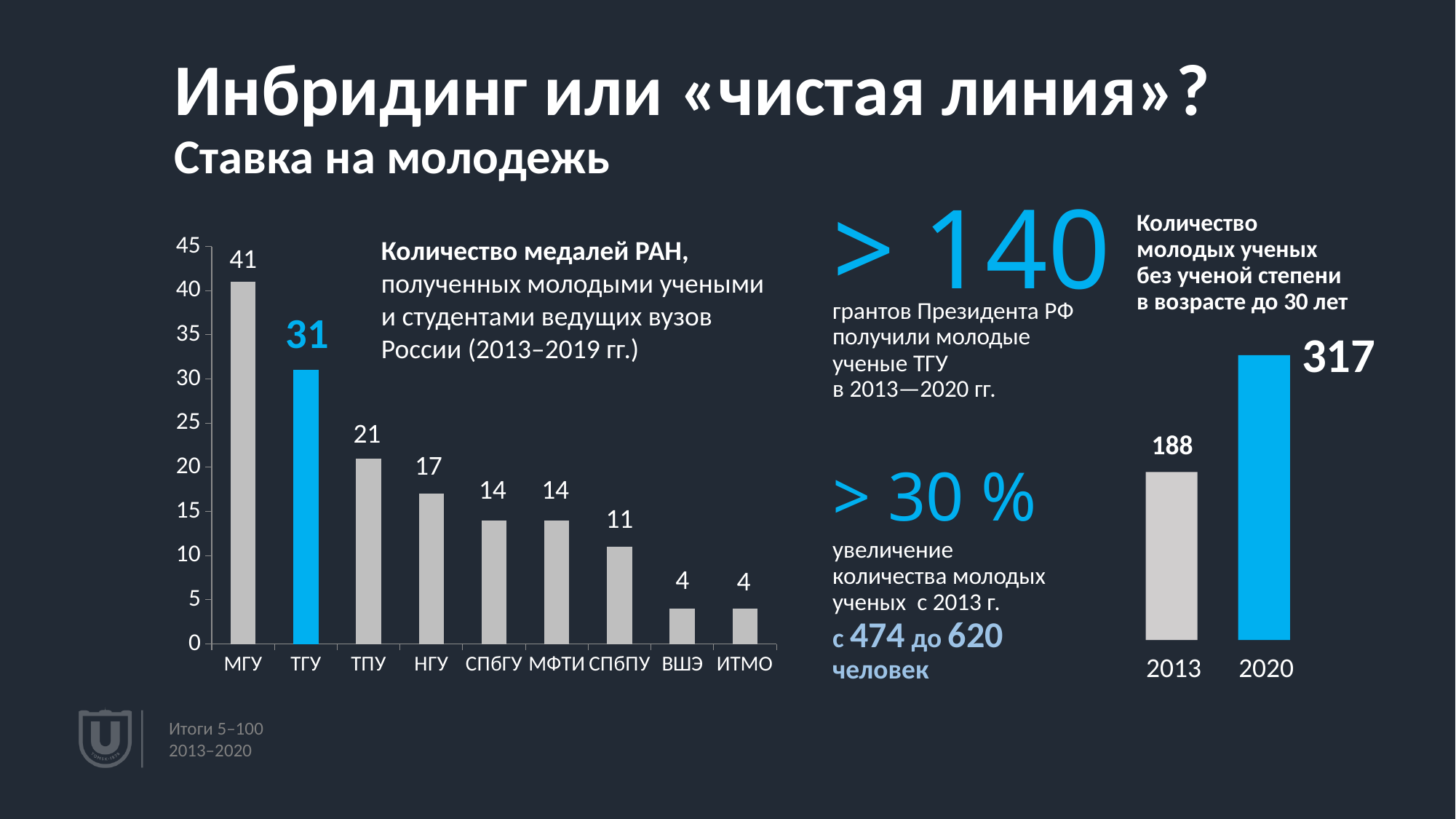
In the chart of RAS medals (Количество медалей РАН), which bar is highlighted in blue? ТГУ What type of chart is the chart of young scientists without a degree on the right of the slide? bar chart In the chart of young scientists without a degree (Количество молодых ученых без ученой степени), what is the value for 2013? 188 In the chart of RAS medals (Количество медалей РАН), which has more medals, ТПУ or НГУ? ТПУ In the chart of young scientists without a degree (Количество молодых ученых без ученой степени), what is the value for 2020? 317 In the chart of RAS medals (Количество медалей РАН), how many medals does СПбПУ have? 11 In the chart of RAS medals (Количество медалей РАН), which university has the highest number of medals? МГУ In the chart of RAS medals (Количество медалей РАН), how many medals does МГУ have? 41 In the chart of young scientists without a degree (Количество молодых ученых без ученой степени), what is the difference between 2020 and 2013? 129 In the chart of RAS medals (Количество медалей РАН), what is the difference between МГУ and ТГУ? 10 In the chart of RAS medals (Количество медалей РАН), how many medals does ТГУ have? 31 In the chart of RAS medals (Количество медалей РАН), how many universities are shown? 9